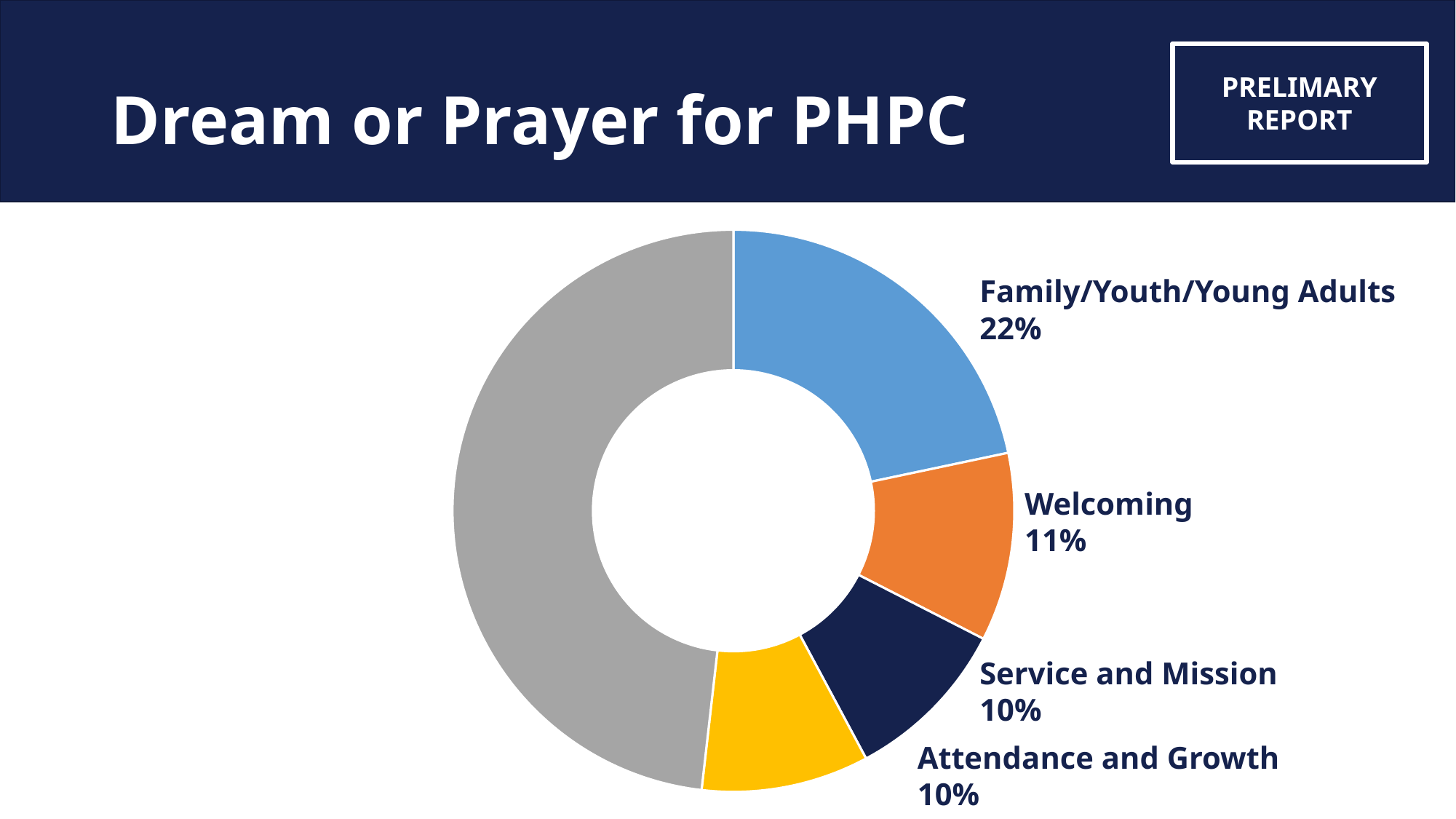
What percentage is shown for Family/Youth/Young Adults? 22% How many slices does the donut chart have? 5 What colour is the Welcoming slice? orange Among the labeled categories, which has the highest percentage? Family/Youth/Young Adults What is the title of the slide containing the chart? Dream or Prayer for PHPC What percentage is shown for Welcoming? 11% What is the difference in percentage points between Family/Youth/Young Adults and Welcoming? 11% What percentage is shown for Service and Mission? 10% Which has a larger percentage, Welcoming or Service and Mission? Welcoming What is the combined percentage of the four labeled categories? 53% What percentage is shown for Attendance and Growth? 10% What kind of chart is shown on the slide? donut (pie) chart